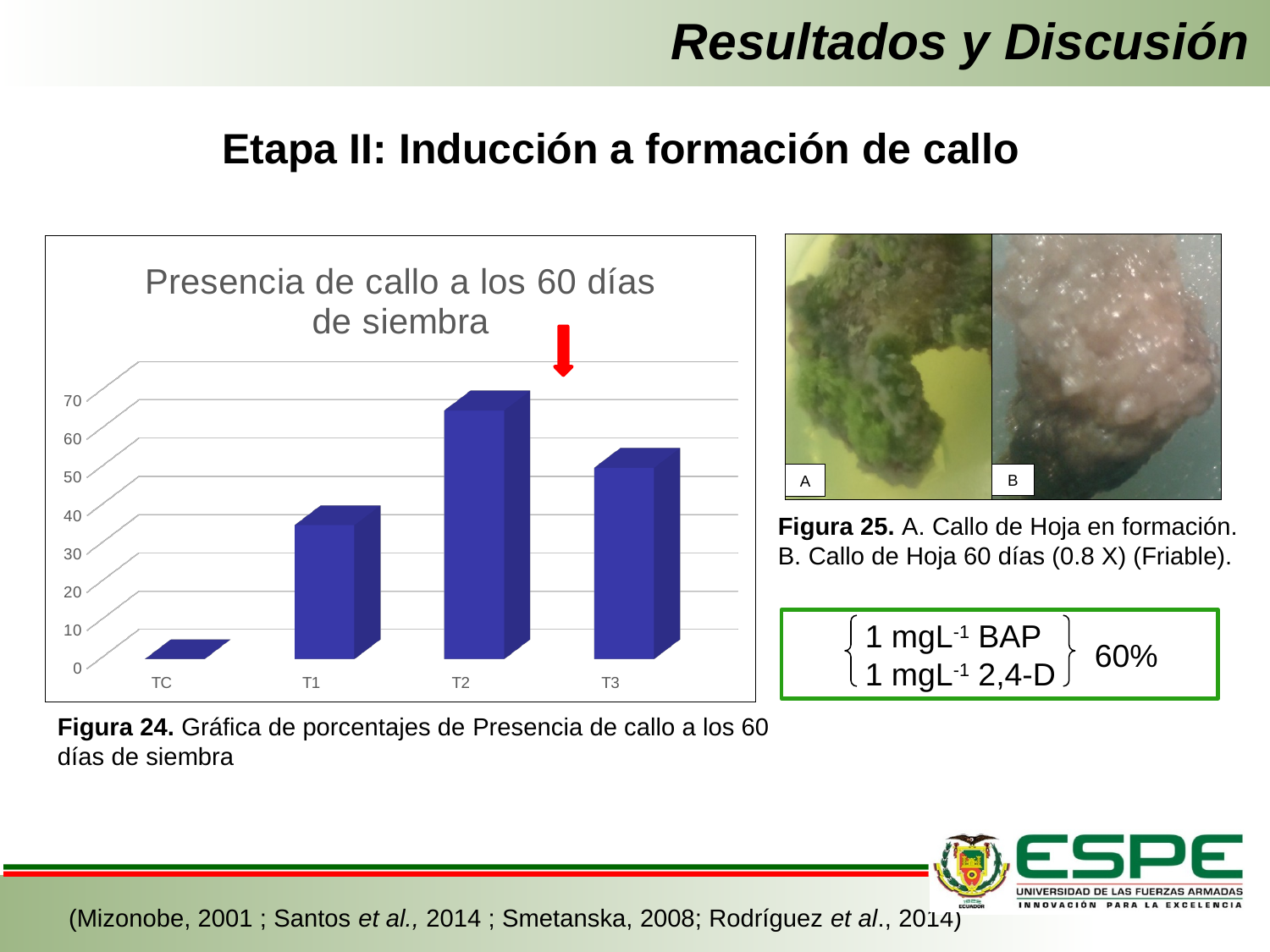
Is the value for TC greater or less than 10? less Is the value for T1 greater or less than 20? greater Do the values rise or fall from T2 to T3? fall What is the title of the chart? Presencia de callo a los 60 días de siembra Which has a larger value, T1 or T3? T3 How many categories are shown on the x axis of the chart? 4 Is the value for T2 greater or less than 50? greater Which category has the lowest value in the chart? TC Which category has the highest value in the chart? T2 What kind of chart is shown on the slide? bar chart